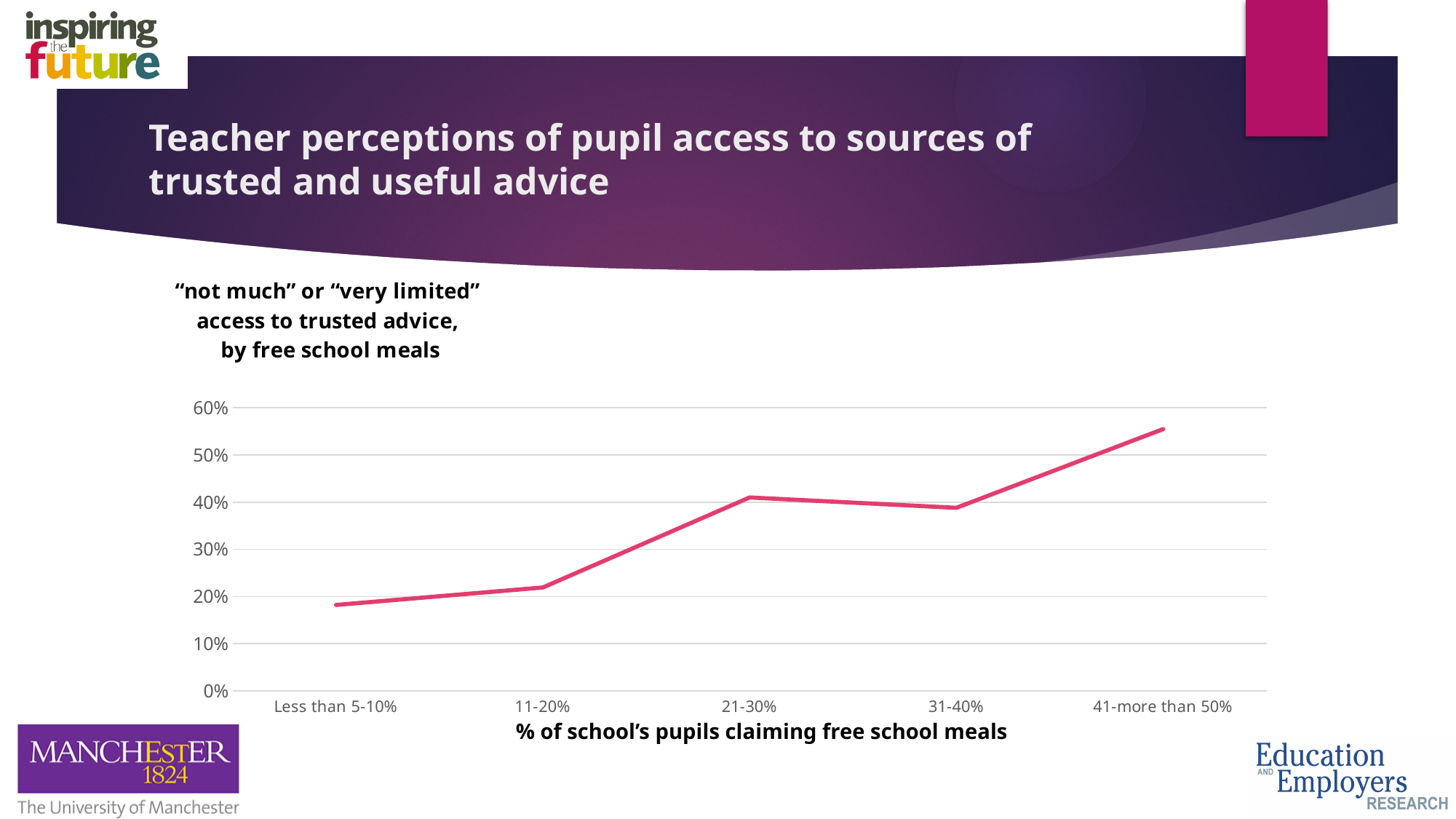
Is the value for 21-30% greater or less than 30%? greater Is the value for 41-more than 50% greater or less than 50%? greater What is the title of the chart? "not much" or "very limited" access to trusted advice, by free school meals Which free school meal category has the lowest share of teachers reporting "not much" or "very limited" access to trusted advice? Less than 5-10% Which has the larger value, 11-20% or 21-30%? 21-30% Which free school meal category has the highest share of teachers reporting "not much" or "very limited" access to trusted advice? 41-more than 50% How many free school meal categories are plotted along the x axis? 5 Is the value for 11-20% greater or less than 30%? less What is the label of the x axis? % of school's pupils claiming free school meals What kind of chart is shown on the slide? line chart Overall, do the values rise or fall as the percentage of pupils claiming free school meals increases? rise